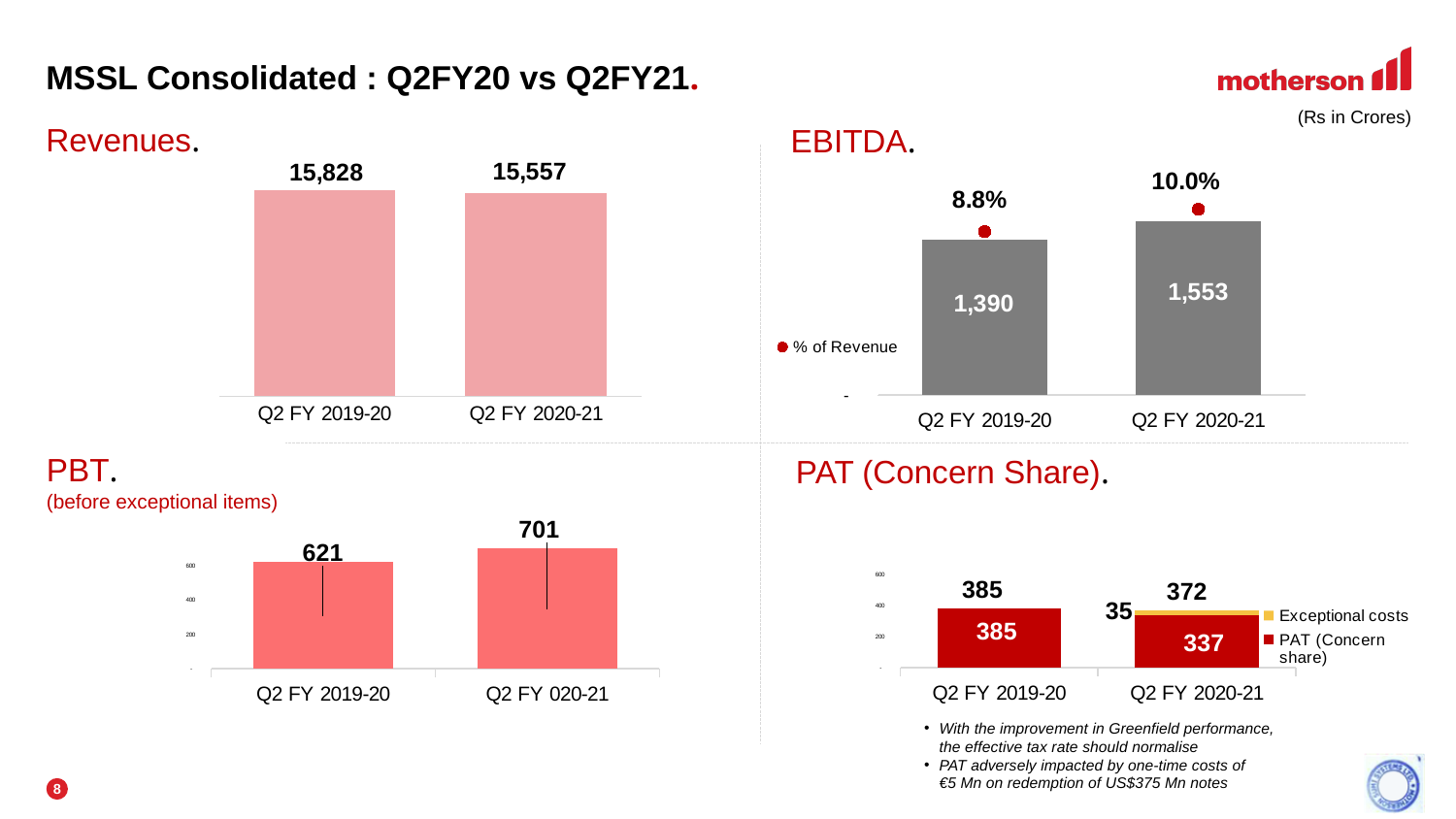
In the PBT chart, what is the value for Q2 FY 2019-20? 621 In the Revenues chart, what is the difference between the Q2 FY 2019-20 and Q2 FY 2020-21 values? 271 In the PAT (Concern Share) chart, what is the PAT (Concern share) value for Q2 FY 2020-21? 337 In the EBITDA chart, what is the % of Revenue for Q2 FY 2019-20? 8.8% In the Revenues chart, what is the value for Q2 FY 2020-21? 15,557 In the EBITDA chart, which quarter has the higher EBITDA value? Q2 FY 2020-21 In the EBITDA chart, what is the EBITDA value for Q2 FY 2020-21? 1,553 How many series does the legend of the PAT (Concern Share) chart list? 2 In the EBITDA chart, what is the difference between the EBITDA values for Q2 FY 2020-21 and Q2 FY 2019-20? 163 In the PAT (Concern Share) chart, what is the total of the stacked bar for Q2 FY 2020-21? 372 In the PBT chart, do the values rise or fall from Q2 FY 2019-20 to the next quarter? rise In the Revenues chart, what is the value for Q2 FY 2019-20? 15,828